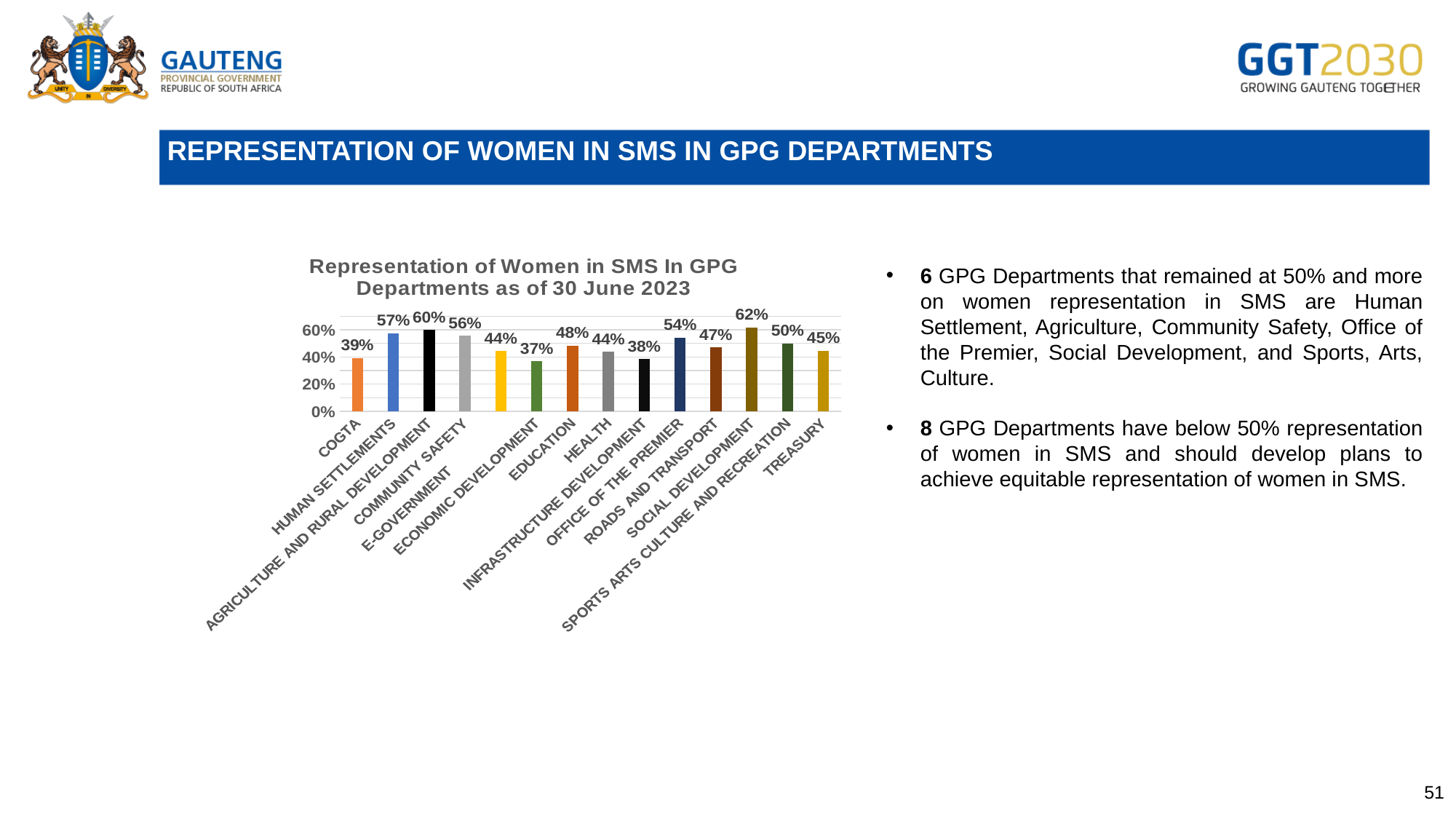
Is the value for Education greater or less than 40%? greater What is the value for Office of the Premier? 54% Which department has the highest representation of women in SMS? Social Development What is the title of the chart? Representation of Women in SMS In GPG Departments as of 30 June 2023 What is the value for Social Development? 62% How many departments are shown in the chart? 14 What is the difference between the values for Agriculture and Rural Development and Treasury? 15% What is the value for COGTA? 39% Which department has the lowest representation of women in SMS? Economic Development What is the value for Infrastructure Development? 38% What kind of chart is shown on the slide? Bar chart Which is larger, the value for Human Settlements or the value for Community Safety? Human Settlements